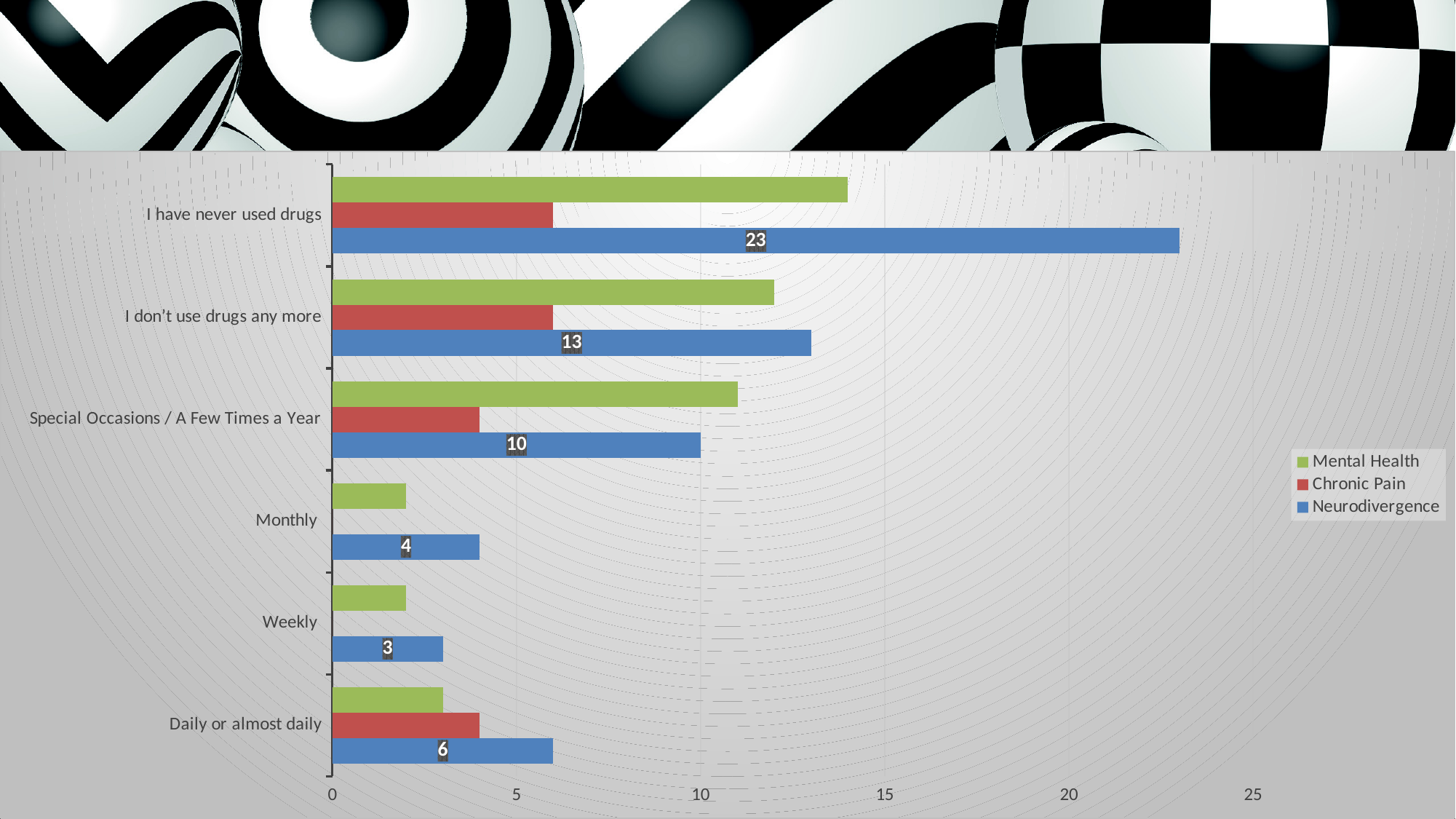
For "Monthly", which series has the larger value: Mental Health or Neurodivergence? Neurodivergence How many series does the legend list? 3 What is the Neurodivergence value for "I don't use drugs any more"? 13 Is the Mental Health value for "I have never used drugs" greater or less than 10? greater What is the Neurodivergence value for "I have never used drugs"? 23 What is the Neurodivergence value for "Daily or almost daily"? 6 How many categories are shown on the chart? 6 What is the difference between the Neurodivergence values for "I have never used drugs" and "I don't use drugs any more"? 10 Is the Chronic Pain value for "Special Occasions / A Few Times a Year" greater or less than 5? less Which category has the highest Neurodivergence value? I have never used drugs Which category has the lowest Neurodivergence value? Weekly What kind of chart is shown on the slide? Bar chart